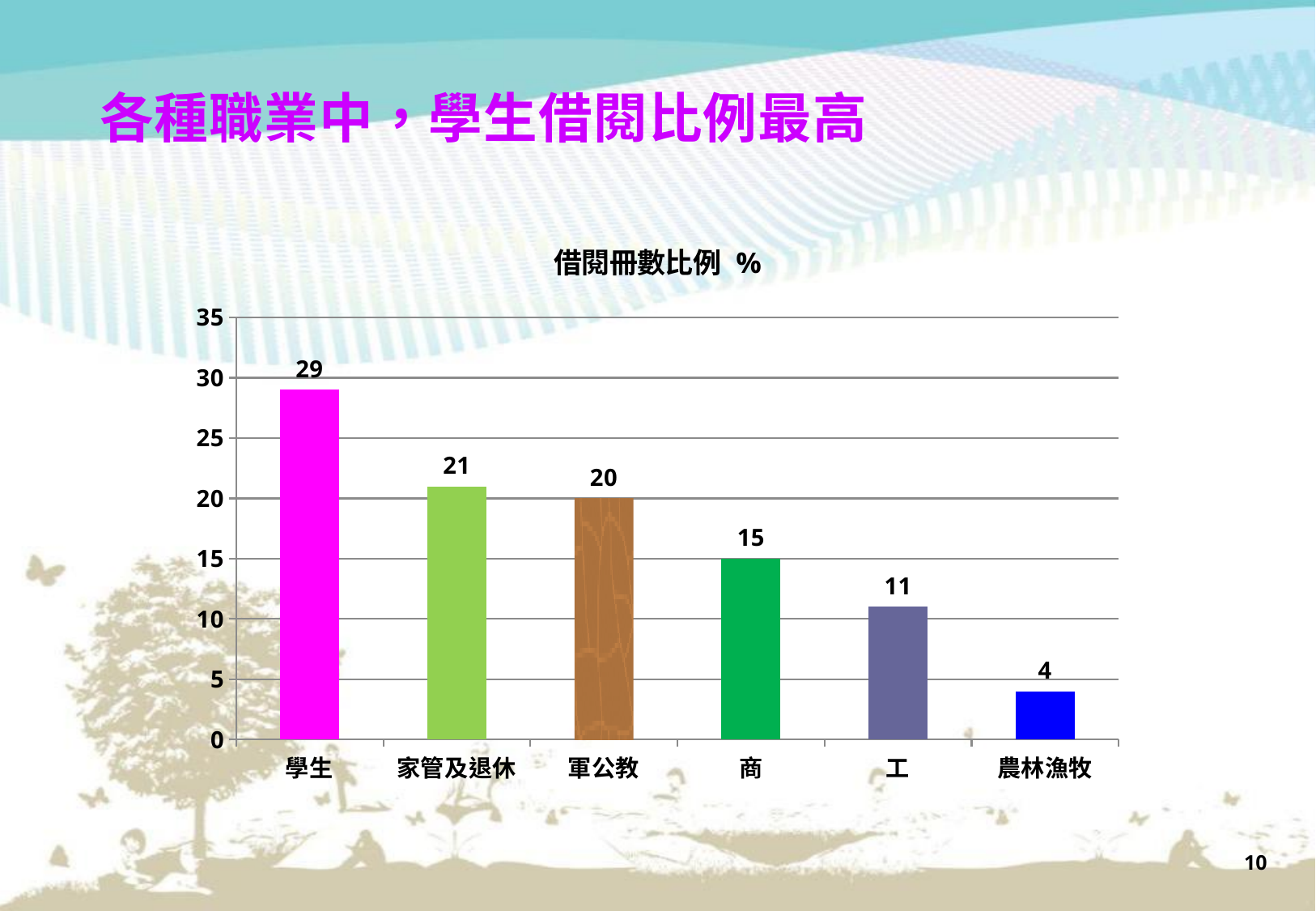
What is the value for 軍公教? 20 What is the difference between the values for 商 and 工? 4 Which category has the highest value? 學生 What is the value for 學生? 29 How many categories are shown on the x axis? 6 What is the title of the chart? 借閱冊數比例 % Which category has the lowest value? 農林漁牧 What is the difference between the values for 學生 and 家管及退休? 8 What kind of chart is this? bar chart Do the values rise or fall from left to right along the x axis? fall Which is larger, the value for 家管及退休 or the value for 商? 家管及退休 What is the value for 農林漁牧? 4